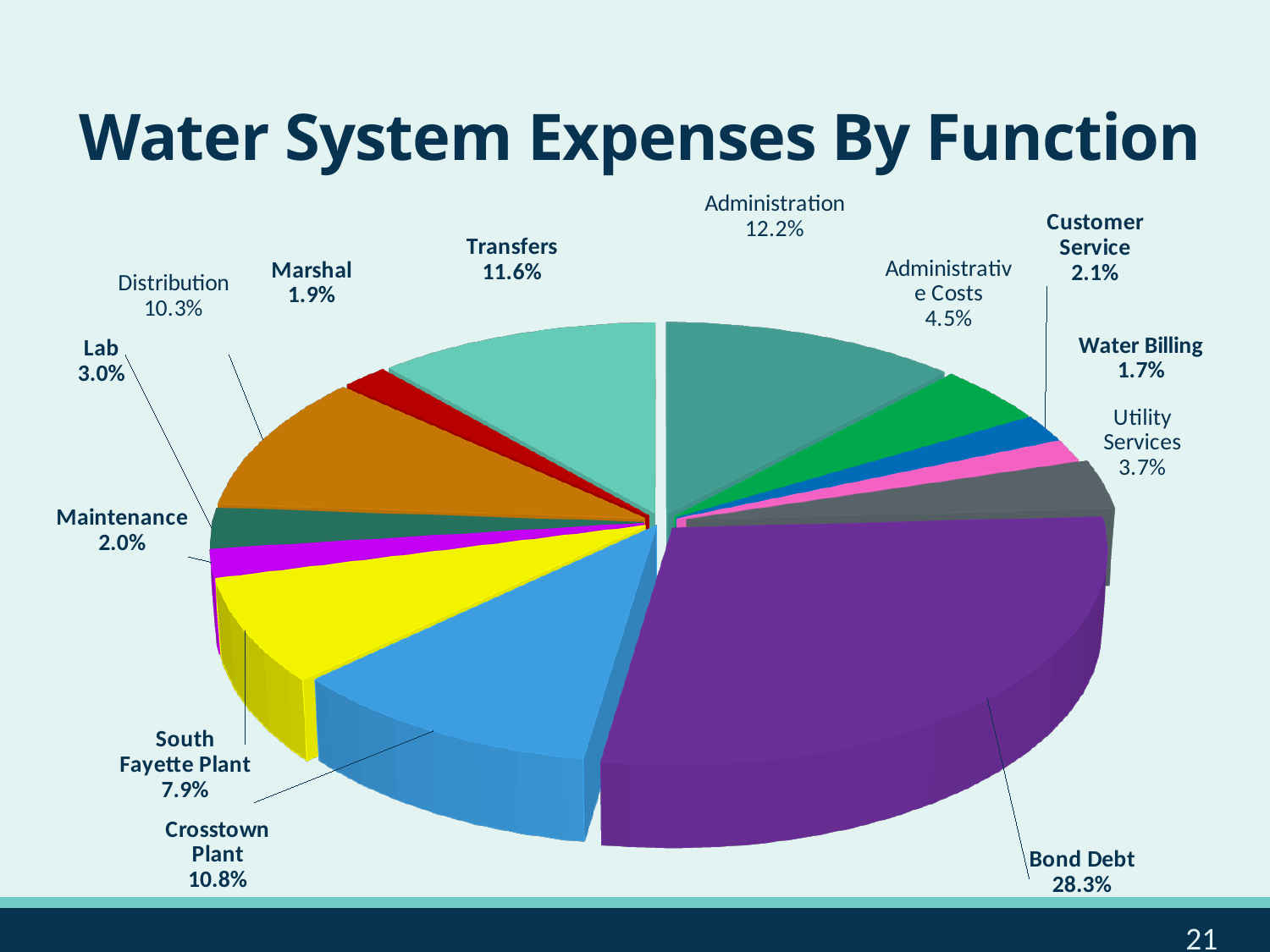
Which function accounts for the smallest share of expenses? Water Billing How many categories are shown in the pie chart? 13 What is the title of the chart? Water System Expenses By Function What is the difference in percentage points between Administration and Administrative Costs? 7.7 What kind of chart is shown on the slide? Pie chart Which function accounts for the largest share of expenses? Bond Debt What percentage is shown for Utility Services? 3.7% What percentage is shown for Crosstown Plant? 10.8% What percentage is shown for Transfers? 11.6% Which has a larger share, Distribution or South Fayette Plant? Distribution What is the combined share of Lab and Maintenance? 5.0% What share of water system expenses is Bond Debt? 28.3%